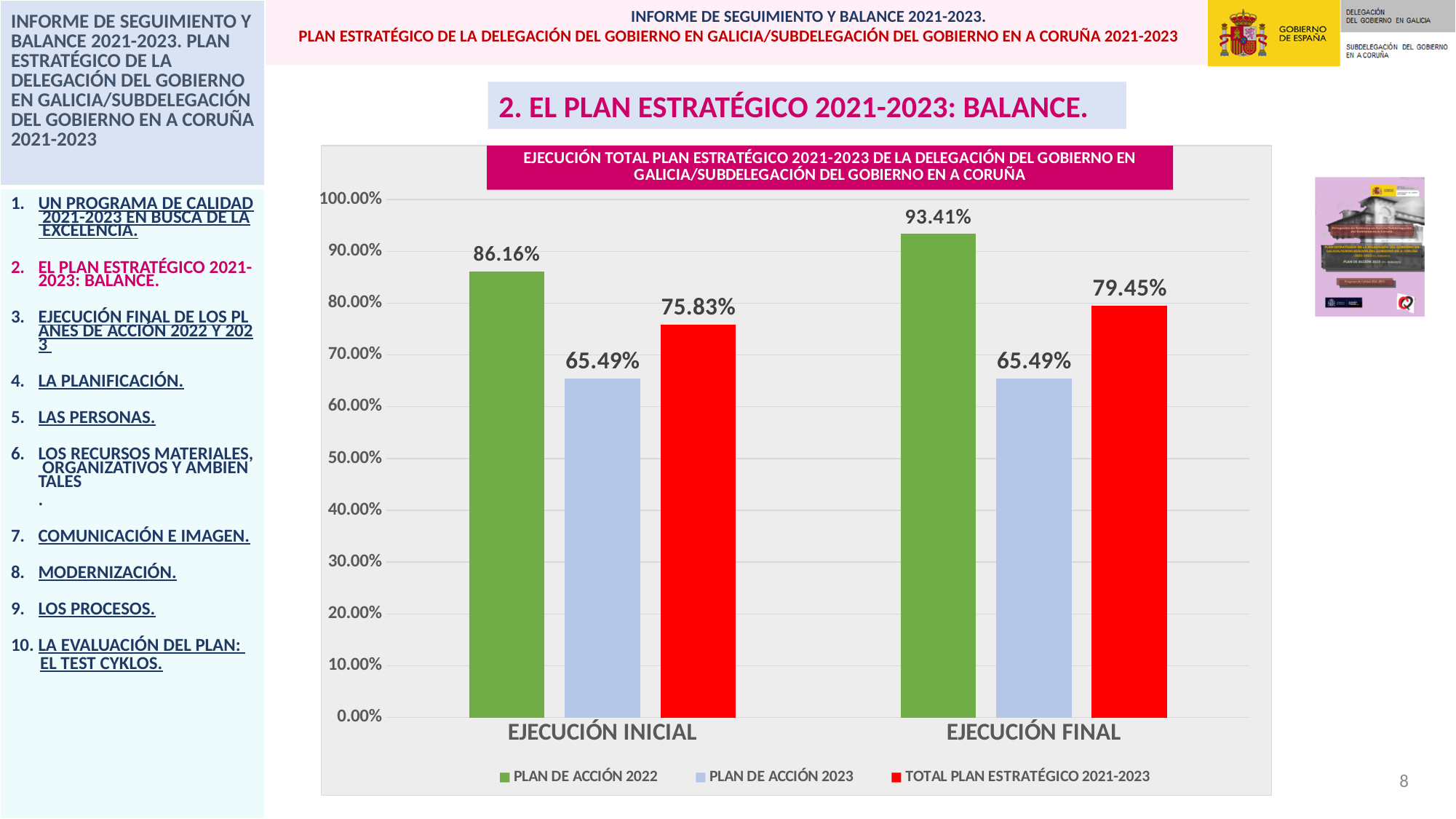
What is the difference between the TOTAL PLAN ESTRATÉGICO 2021-2023 values for EJECUCIÓN FINAL and EJECUCIÓN INICIAL? 3.62% What is the difference between the PLAN DE ACCIÓN 2022 values for EJECUCIÓN FINAL and EJECUCIÓN INICIAL? 7.25% What is the value for PLAN DE ACCIÓN 2022 in the EJECUCIÓN FINAL group? 93.41% What kind of chart is shown on the slide? Bar chart What is the value for PLAN DE ACCIÓN 2022 in the EJECUCIÓN INICIAL group? 86.16% Which is larger: TOTAL PLAN ESTRATÉGICO 2021-2023 for EJECUCIÓN INICIAL or PLAN DE ACCIÓN 2023 for EJECUCIÓN FINAL? TOTAL PLAN ESTRATÉGICO 2021-2023 for EJECUCIÓN INICIAL Which series has the lowest value in the EJECUCIÓN INICIAL group? PLAN DE ACCIÓN 2023 How many series does the legend list? 3 Which series has the highest value in the EJECUCIÓN FINAL group? PLAN DE ACCIÓN 2022 What is the value for PLAN DE ACCIÓN 2023 in the EJECUCIÓN INICIAL group? 65.49% What is the value for TOTAL PLAN ESTRATÉGICO 2021-2023 in the EJECUCIÓN FINAL group? 79.45% How many category groups are shown on the x axis? 2